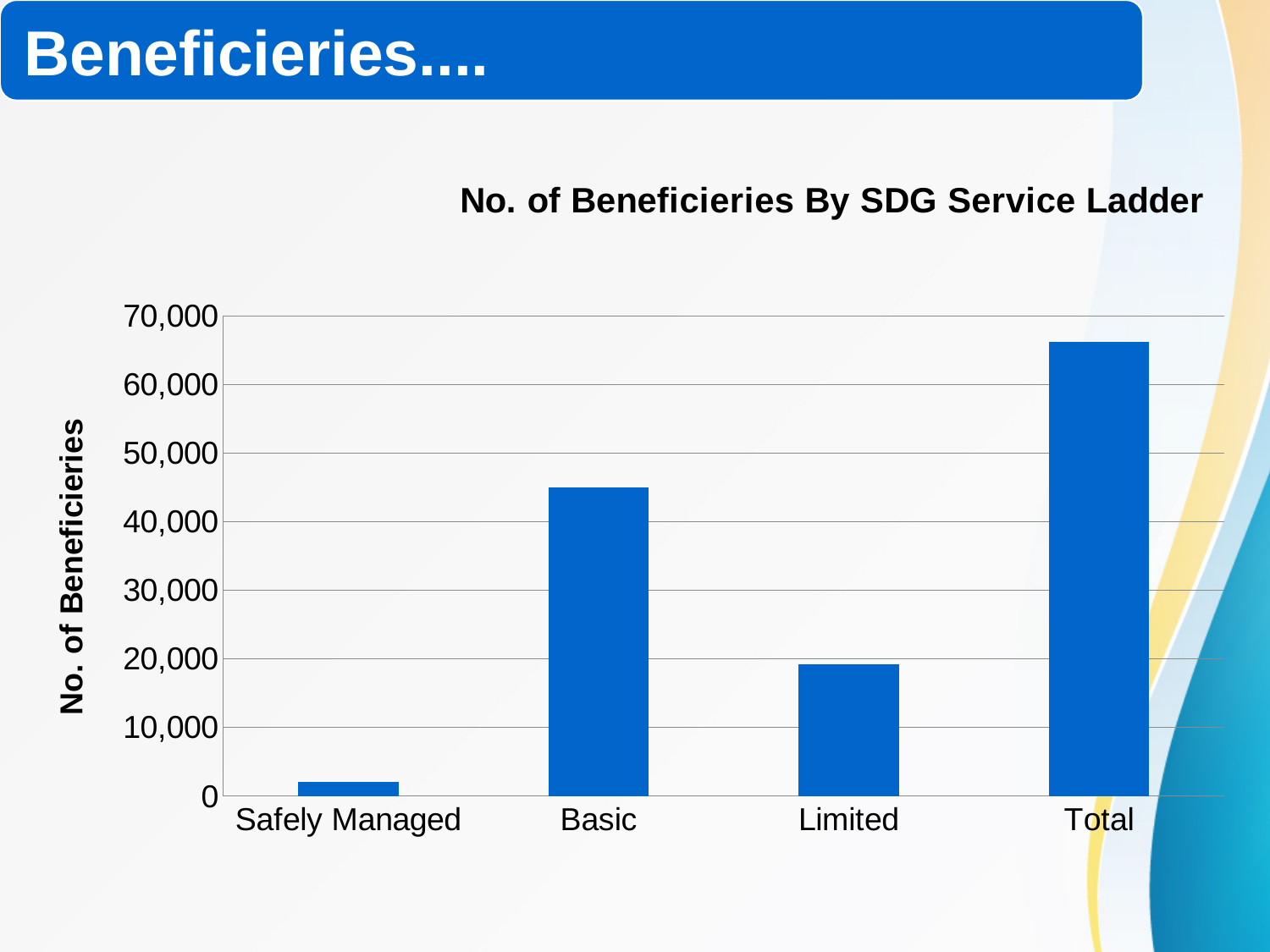
Is the value for Safely Managed greater or less than 10,000? less How many categories are shown on the x axis? 4 Is the value for Total greater or less than 60,000? greater What is the label of the y axis? No. of Beneficieries Which category has the lowest number of beneficiaries? Safely Managed Is the value for Basic greater or less than 50,000? less What is the title of the chart? No. of Beneficieries By SDG Service Ladder What type of chart is shown on the slide? bar chart Which is larger, the value for Basic or the value for Limited? Basic Which category has the highest number of beneficiaries? Total